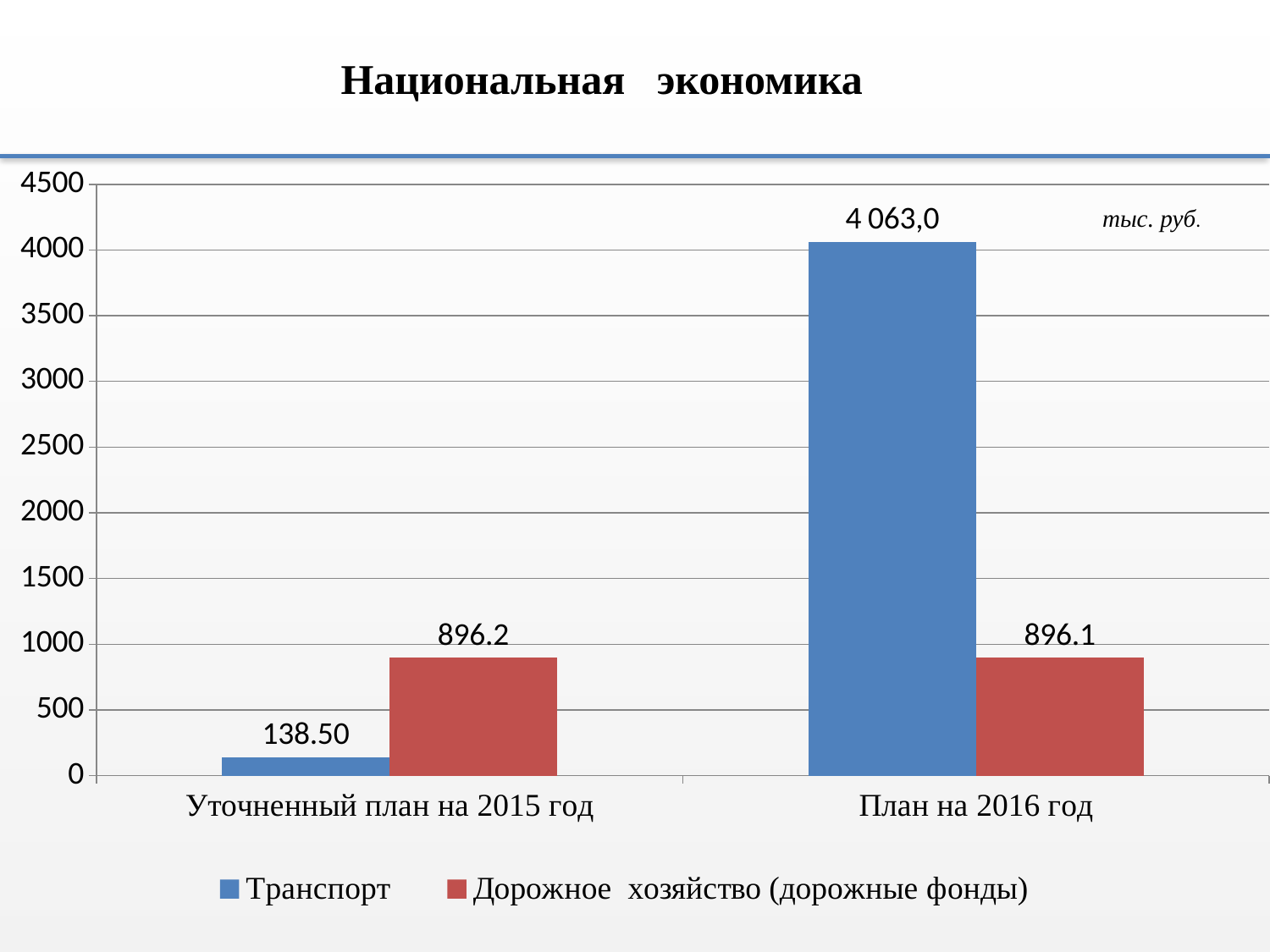
What is the value for Дорожное хозяйство (дорожные фонды) in План на 2016 год? 896.1 In План на 2016 год, which is larger: Транспорт or Дорожное хозяйство (дорожные фонды)? Транспорт What is the value for Транспорт in План на 2016 год? 4 063,0 What is the difference between Дорожное хозяйство (дорожные фонды) and Транспорт in Уточненный план на 2015 год? 757.7 Which bar has the lowest value on the chart? Транспорт, Уточненный план на 2015 год What kind of chart is shown on the slide? bar chart Is the value for Транспорт in План на 2016 год greater or less than 4000? greater What is the value for Дорожное хозяйство (дорожные фонды) in Уточненный план на 2015 год? 896.2 What is the value for Транспорт in Уточненный план на 2015 год? 138.50 How many categories are shown on the x axis? 2 Which bar has the highest value on the chart? Транспорт, План на 2016 год How many series does the legend list? 2